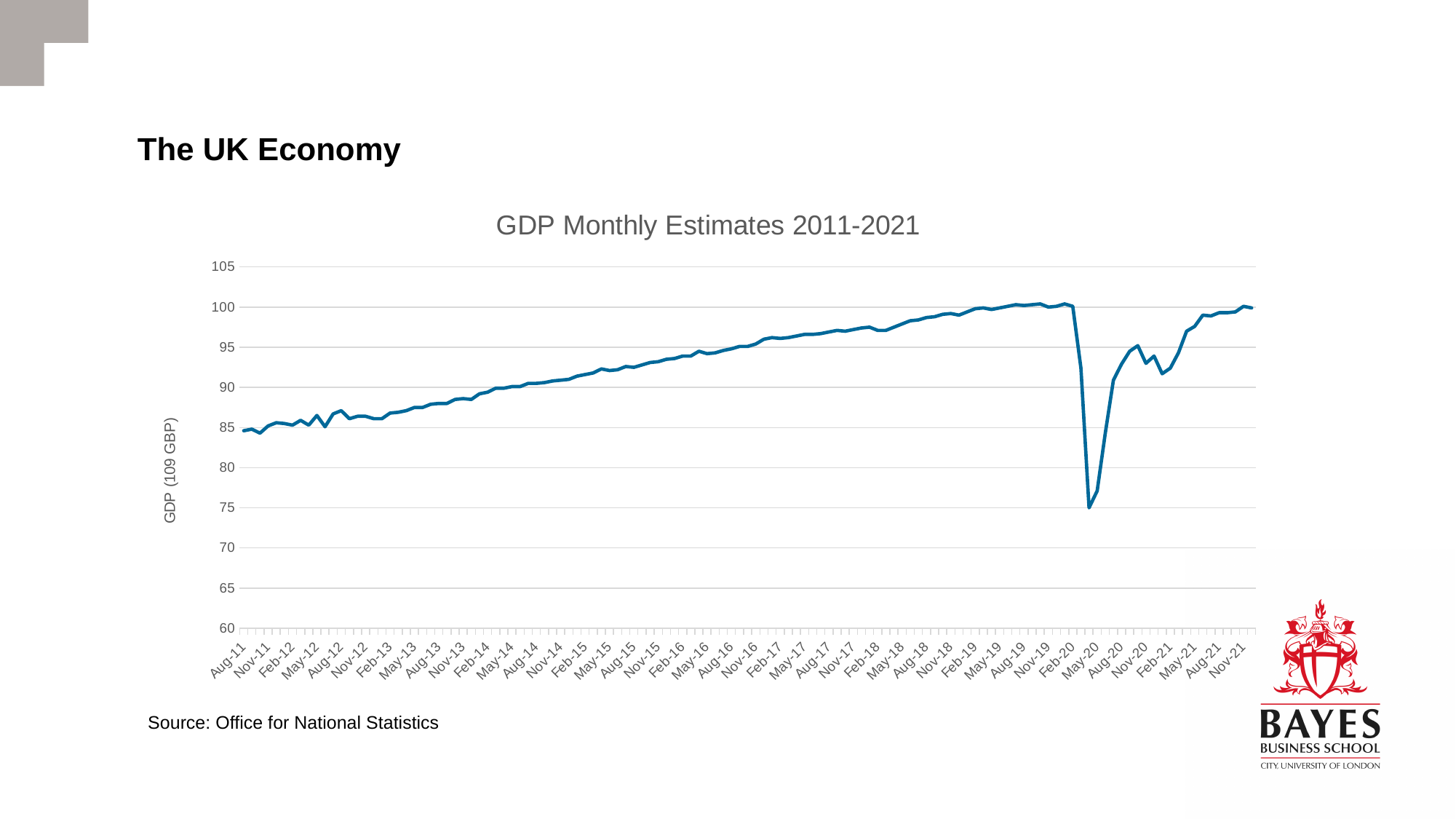
What is the title of the chart? GDP Monthly Estimates 2011-2021 Is the value for May-20 greater or less than 80? less What kind of chart is shown on the slide? line chart What is the label on the vertical axis of the chart? GDP (109 GBP) Is the value for Nov-17 greater or less than 100? less Which is larger, the value for Nov-21 or the value for Aug-11? Nov-21 Is the value for Nov-21 greater or less than 95? greater How many lines are plotted on the chart? 1 Does GDP generally rise or fall between Aug-11 and Feb-20? rise Does GDP rise or fall between Feb-20 and May-20? fall Which is larger, the value for Feb-20 or the value for May-20? Feb-20